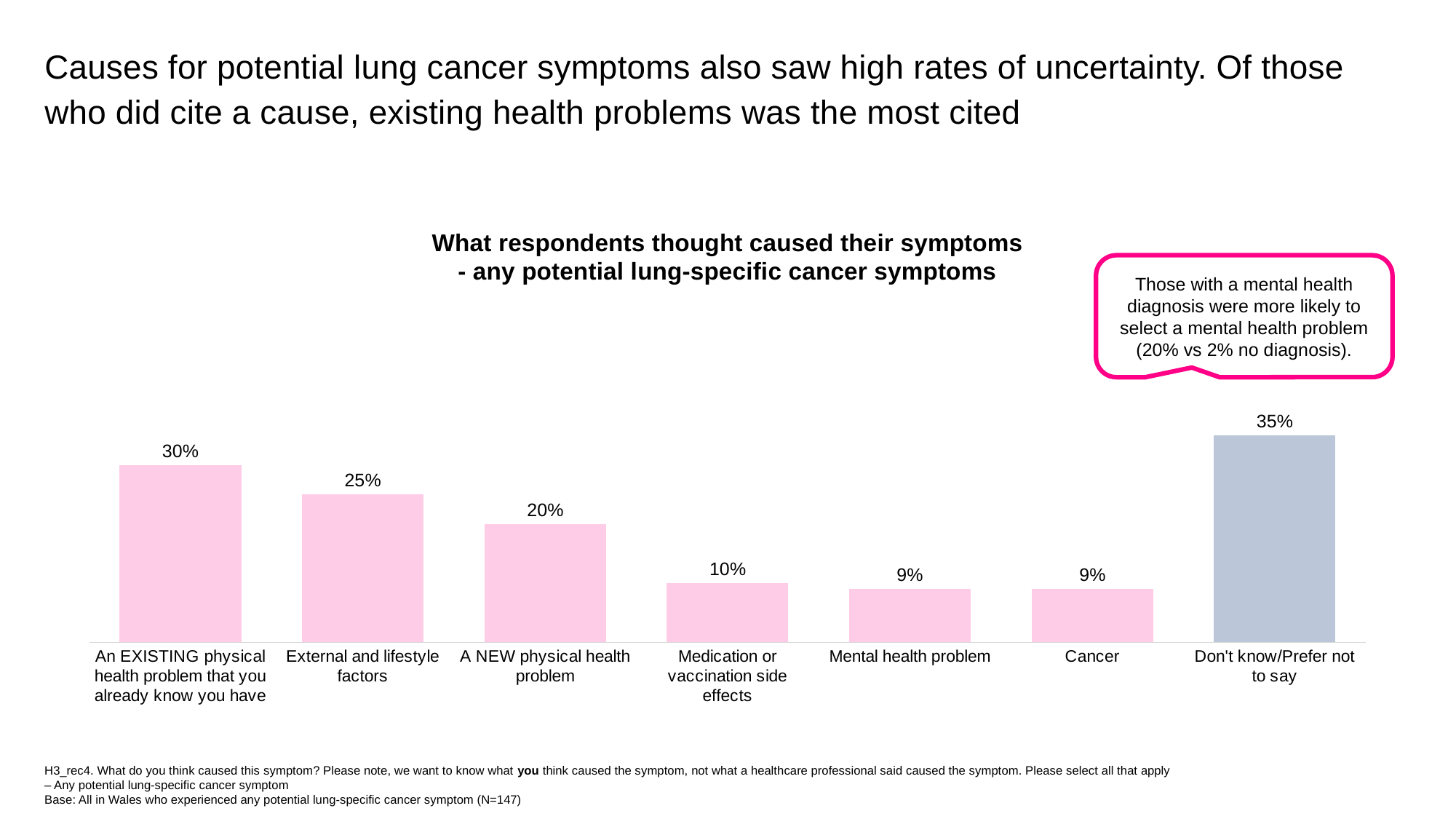
How many categories are shown in the chart? 7 Which is larger: the value for 'A NEW physical health problem' or the value for 'Medication or vaccination side effects'? A NEW physical health problem What value is shown for 'External and lifestyle factors'? 25% Which category has the highest value in the chart? Don't know/Prefer not to say What percentage of respondents selected 'Medication or vaccination side effects'? 10% What is the difference between the value for 'Don't know/Prefer not to say' and the value for 'External and lifestyle factors'? 10% Which bar is coloured differently (grey-blue) from the other pink bars? Don't know/Prefer not to say What type of chart is shown on the slide? Bar chart What percentage of respondents cited an existing physical health problem that they already know they have as the cause of their symptoms? 30% What is the title of the chart? What respondents thought caused their symptoms - any potential lung-specific cancer symptoms What value is shown for 'Cancer'? 9% What is the difference between the value for 'An EXISTING physical health problem that you already know you have' and the value for 'A NEW physical health problem'? 10%